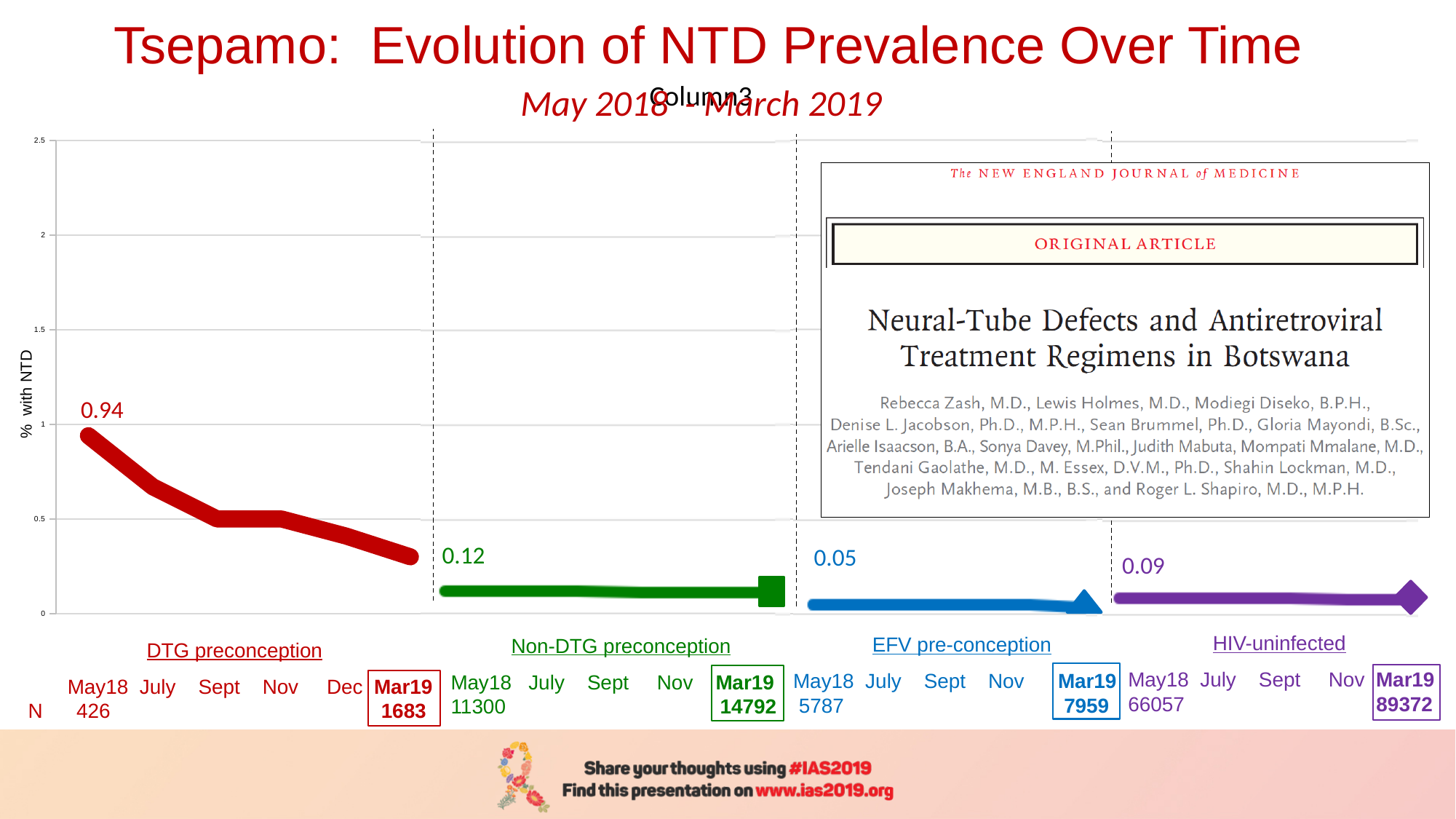
What is the labelled % with NTD for the HIV-uninfected group? 0.09 Which exposure group has the lowest labelled % with NTD? EFV pre-conception Which exposure group has the highest labelled % with NTD? DTG preconception What kind of chart is shown on the slide? line chart Which is larger, the % with NTD for HIV-uninfected or for EFV pre-conception? HIV-uninfected Does the DTG preconception line rise or fall from May18 to Mar19? falls What is the difference between the HIV-uninfected value and the EFV pre-conception value? 0.04 What is the difference between the DTG preconception value at May18 (0.94) and the Non-DTG preconception value (0.12)? 0.82 What is the labelled % with NTD for the Non-DTG preconception group? 0.12 Is the DTG preconception value at Mar19 greater or less than 0.5? less What is the labelled % with NTD for DTG preconception at May18? 0.94 What is the labelled % with NTD for the EFV pre-conception group? 0.05